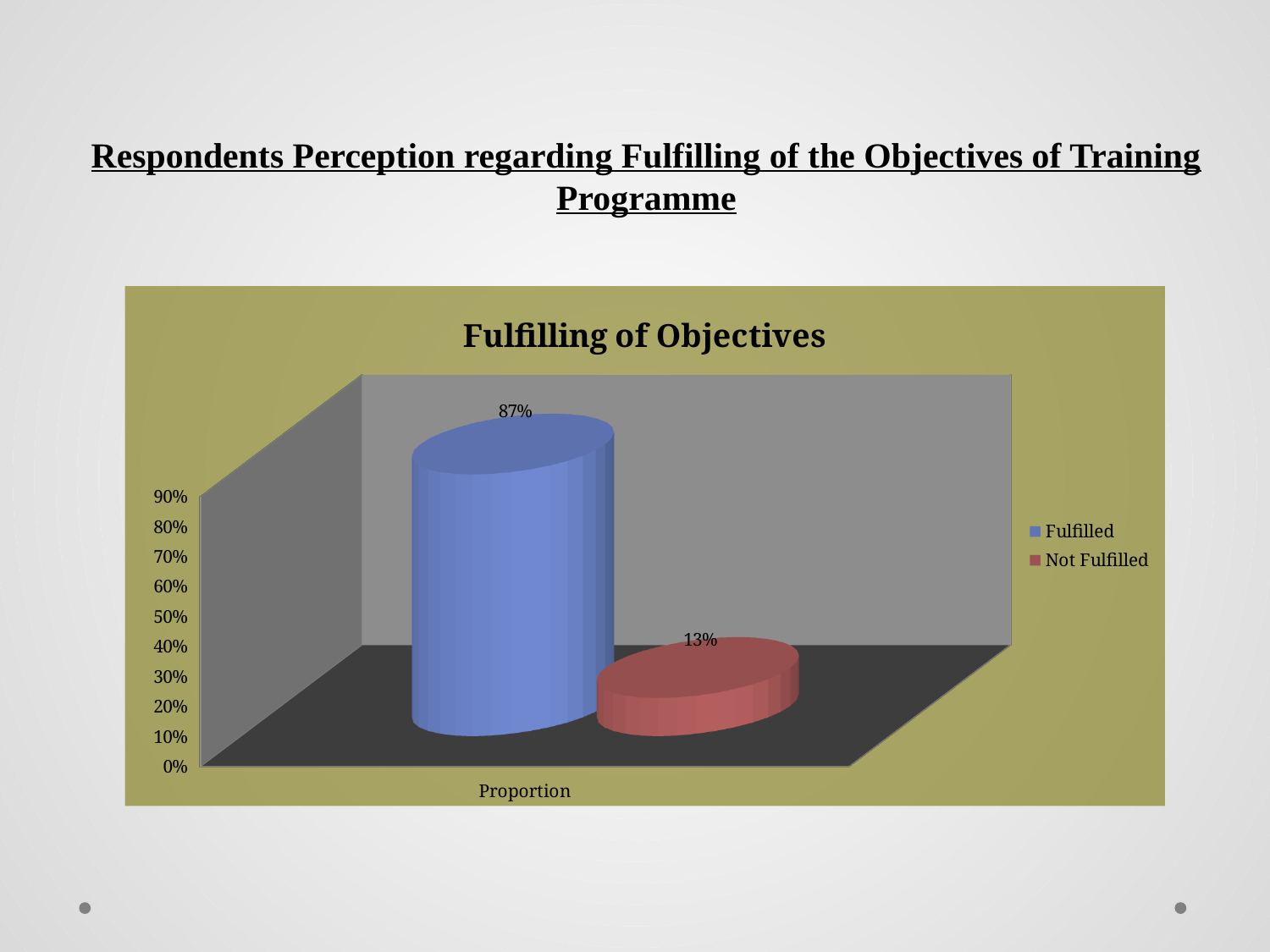
What is the difference between the Fulfilled and Not Fulfilled values? 74% Which series has the highest value? Fulfilled What is the value for Not Fulfilled? 13% What is the title of the chart? Fulfilling of Objectives What is the value for Fulfilled? 87% Is the value for Fulfilled greater or less than 50%? greater What kind of chart is shown? bar chart What is the label on the x axis category? Proportion Is the value for Not Fulfilled greater or less than 20%? less How many series does the legend list? 2 Which is larger, the value for Fulfilled or the value for Not Fulfilled? Fulfilled Which series has the lowest value? Not Fulfilled